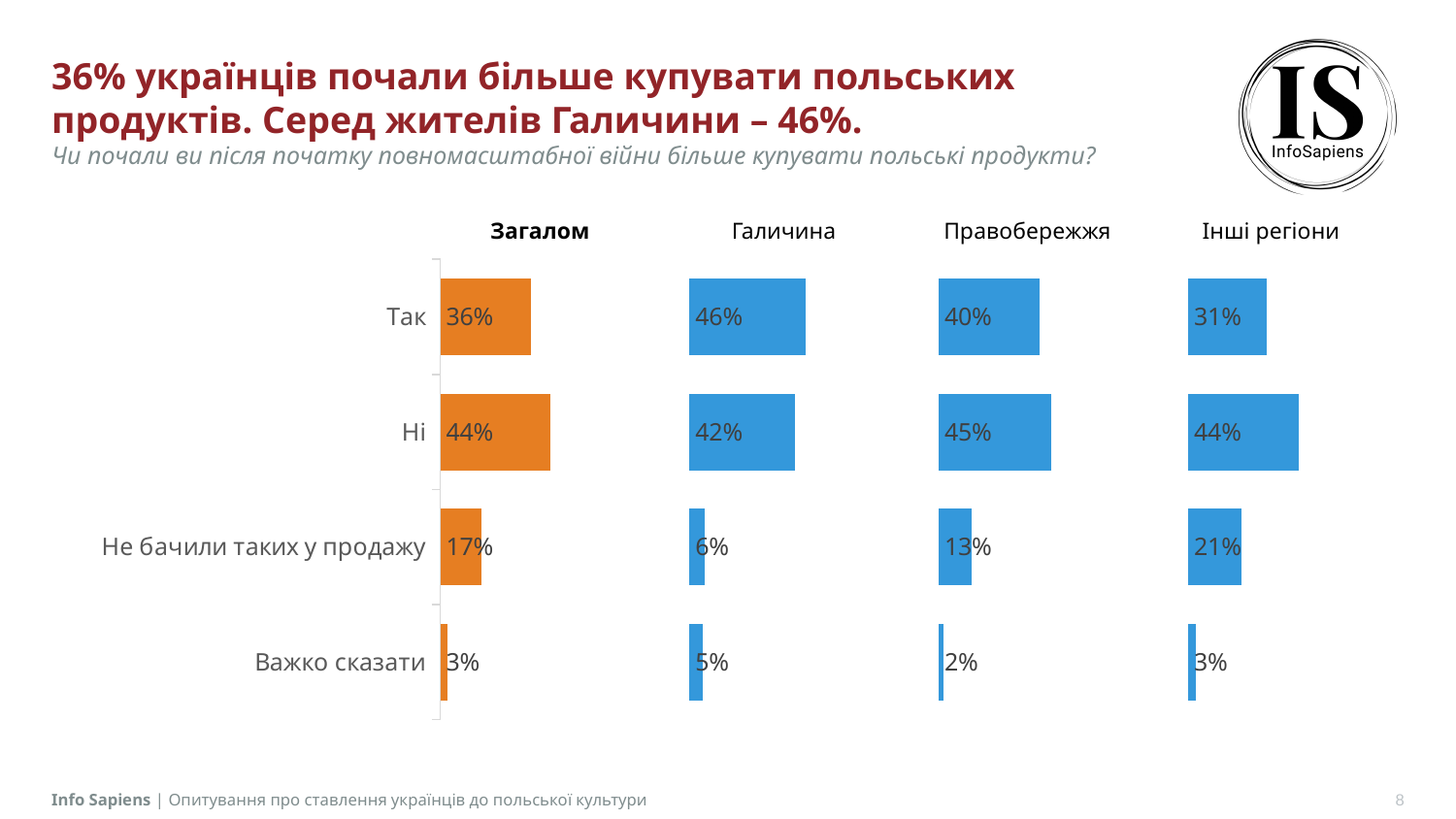
What colour are the bars in the "Загалом" chart? Orange In the "Інші регіони" chart, what is the value for "Не бачили таких у продажу"? 21% How many categories are shown in the "Загалом" chart? 4 In the "Інші регіони" chart, which is larger: the value for "Так" or the value for "Ні"? Ні In the "Правобережжя" chart, what is the value for "Ні"? 45% In the "Загалом" chart, what is the difference between the values for "Ні" and "Так"? 8% What type of chart is used on this slide? Bar chart In the "Загалом" chart, what is the value for "Так"? 36% In the "Галичина" chart, which category has the highest value? Так In the "Галичина" chart, what is the value for "Не бачили таких у продажу"? 6% In the "Галичина" chart, what is the difference between the values for "Так" and "Ні"? 4% In the "Правобережжя" chart, which category has the lowest value? Важко сказати